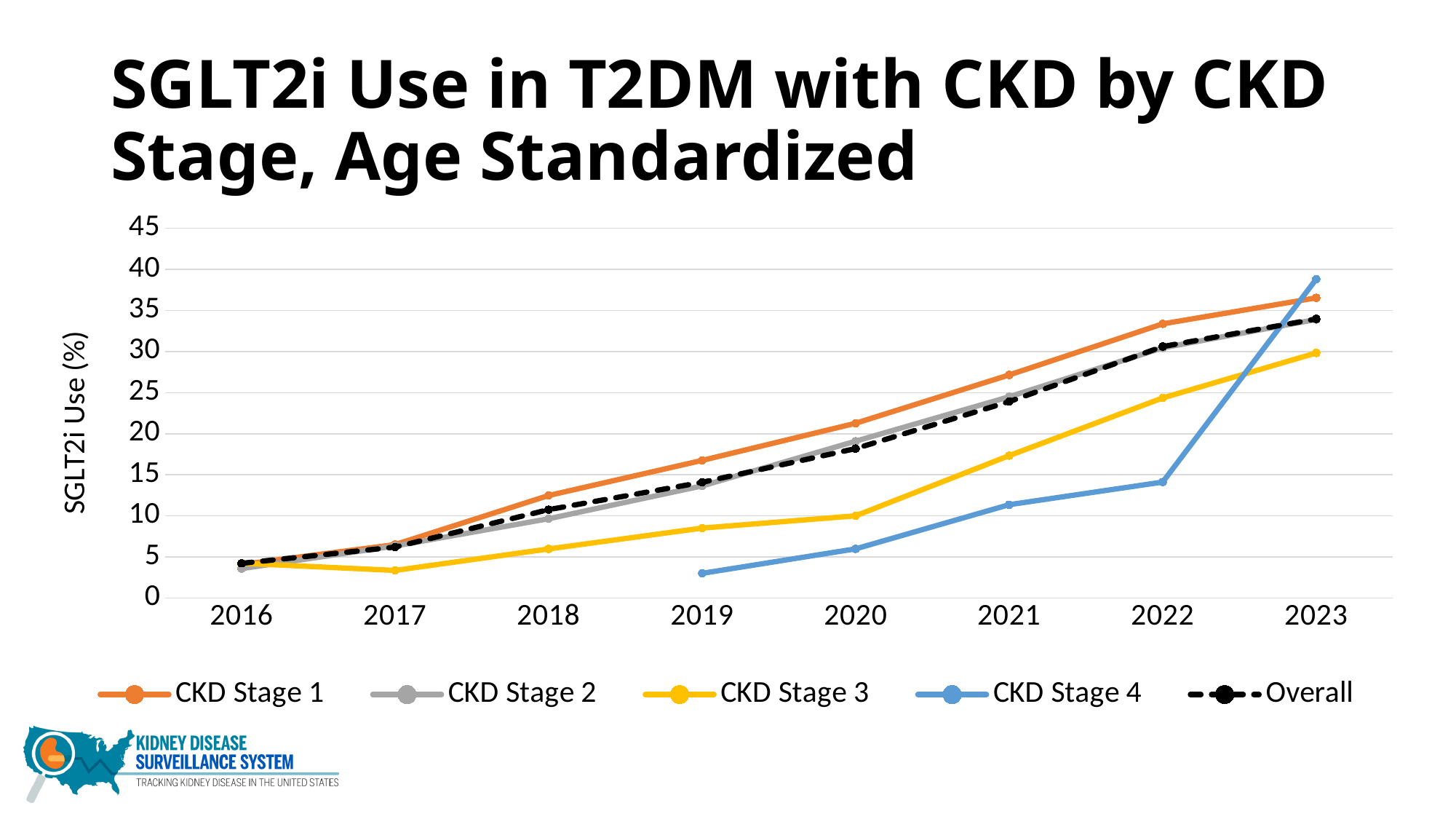
Which series is drawn with a dashed line? Overall How many series does the legend list? 5 How many years are shown on the x axis? 8 Does the CKD Stage 1 line rise or fall from 2016 to 2023? rise What type of chart is shown on the slide? line chart Which series has the highest value in 2023? CKD Stage 4 Which series has the lowest value in 2021? CKD Stage 4 Is the value for CKD Stage 3 in 2020 greater or less than 15? less Is the value for Overall in 2018 greater or less than 15? less Is the value for CKD Stage 4 in 2023 greater or less than 35? greater In 2022, which is larger: the value for CKD Stage 3 or the value for CKD Stage 4? CKD Stage 3